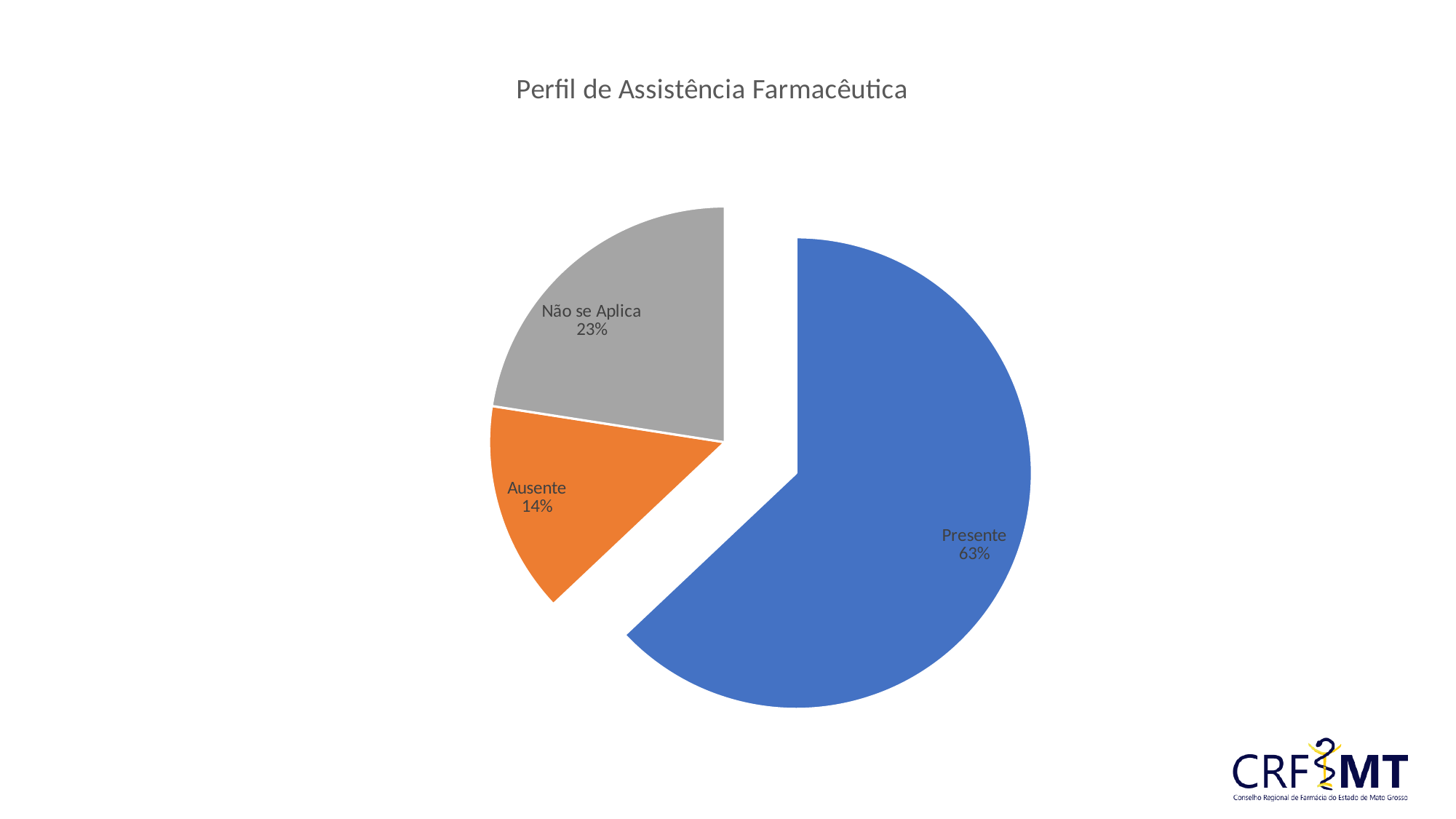
Which is larger, the Ausente slice or the Não se Aplica slice? Não se Aplica What kind of chart is shown on the slide? pie chart What percentage of the pie is labelled Ausente? 14% Which slice of the pie is the largest? Presente Which slice of the pie is the smallest? Ausente What is the difference in percentage points between Não se Aplica and Ausente? 9 How many slices does the pie chart have? 3 What percentage of the pie is labelled Não se Aplica? 23% What colour is the Presente slice? blue What percentage of the pie is labelled Presente? 63% What is the difference in percentage points between Presente and Não se Aplica? 40 What is the title of the chart? Perfil de Assistência Farmacêutica